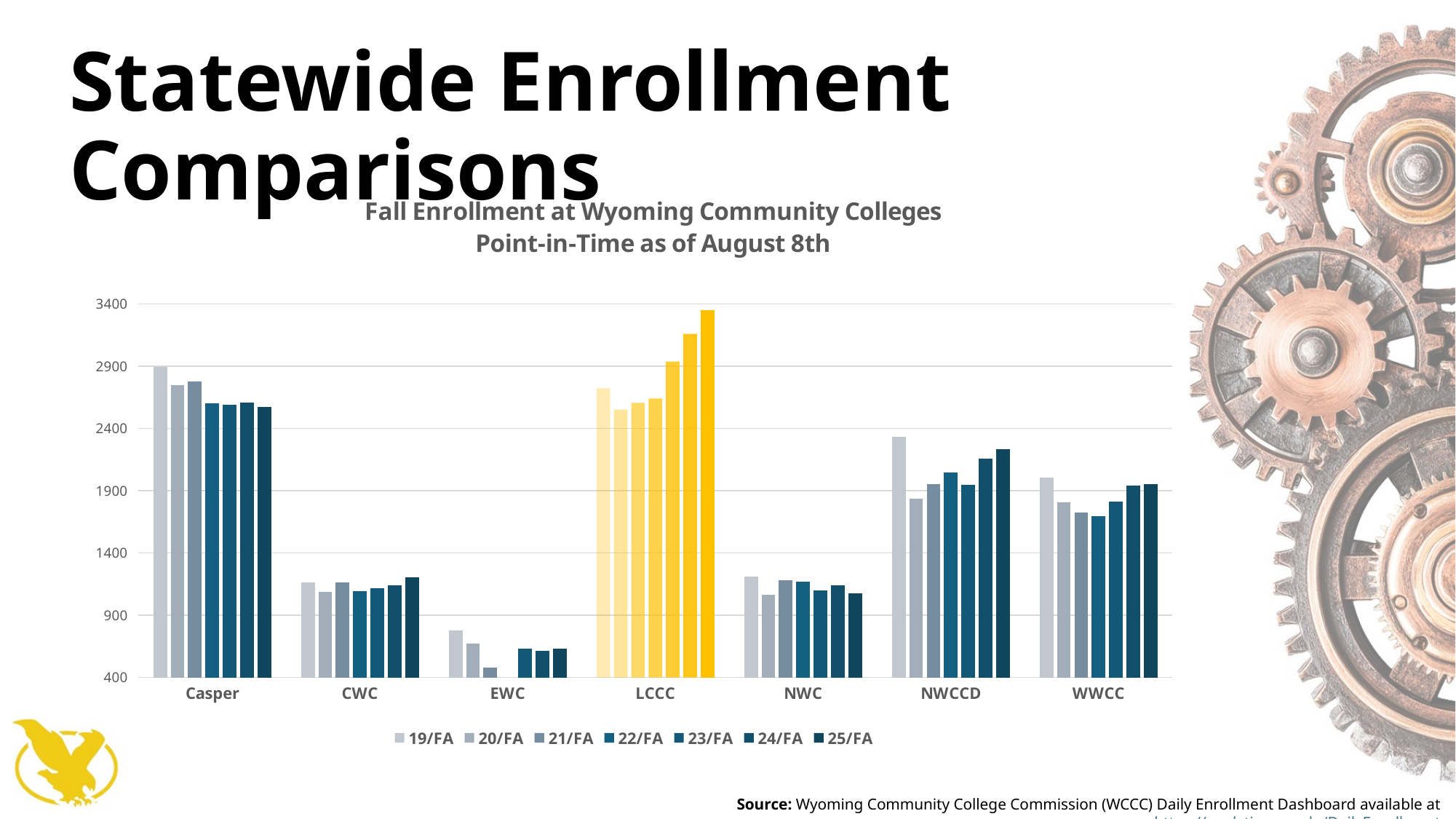
Is the 25/FA value for EWC greater or less than 900? less How many series does the legend list? 7 How many colleges (categories) are shown on the x axis of the chart? 7 What kind of chart is shown on the slide? Bar chart Which college's bars are coloured yellow/gold in the chart? LCCC Which college has the lowest enrollment bars in the chart? EWC Do the LCCC enrollment values rise or fall from 20/FA to 25/FA? rise Which college has the highest enrollment bars in the chart? LCCC Which is larger, the 19/FA value for Casper or the 19/FA value for WWCC? Casper Is the 19/FA value for NWCCD greater or less than 1900? greater Is the 25/FA value for LCCC greater or less than 2900? greater What is the title of the chart? Fall Enrollment at Wyoming Community Colleges Point-in-Time as of August 8th